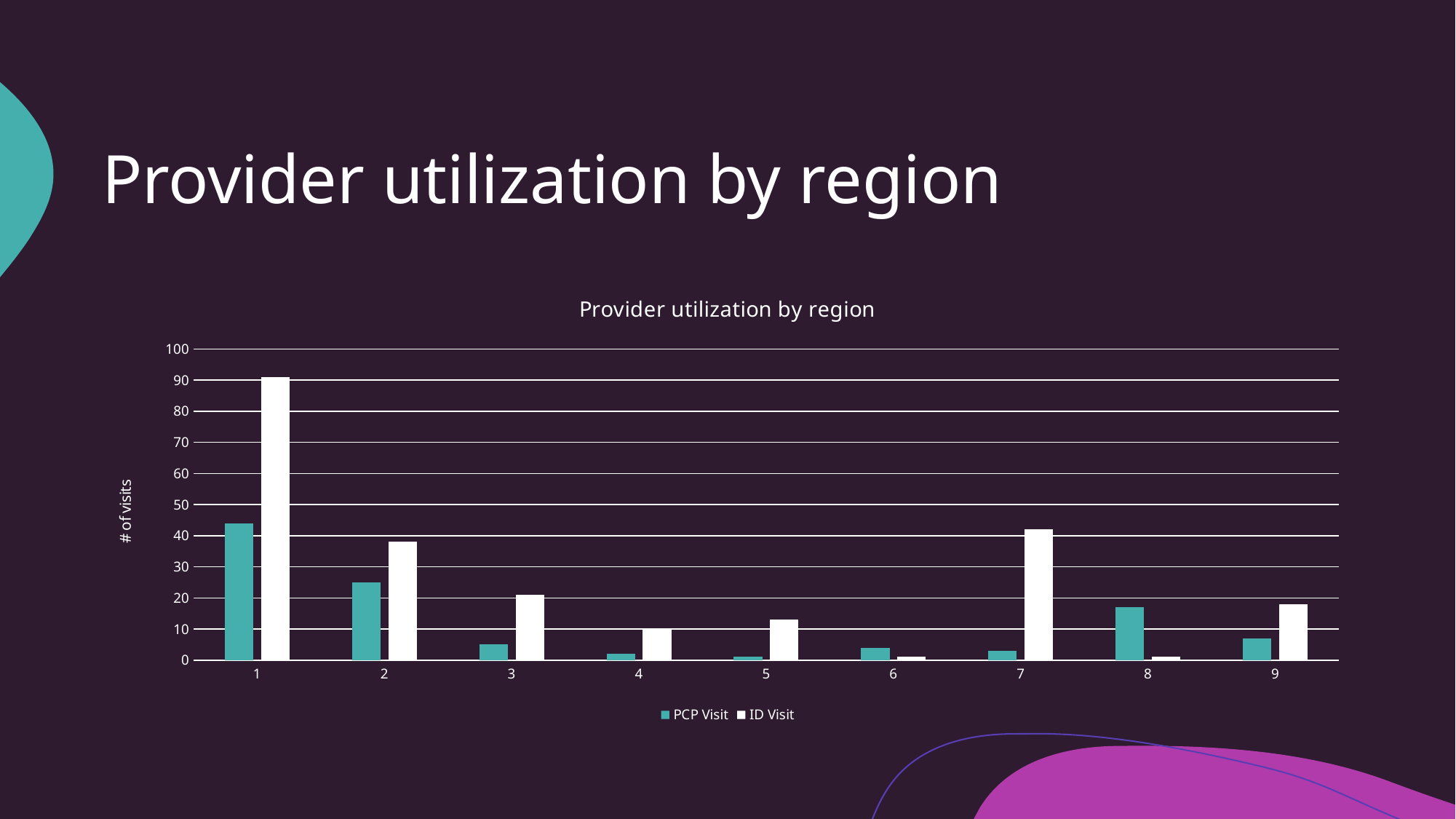
Is the ID Visit value for region 1 greater or less than 80? greater What is the title of the vertical axis? # of visits How many series does the legend list? 2 Is the ID Visit value for region 7 greater or less than 30? greater Is the PCP Visit value for region 2 greater or less than 30? less What kind of chart is shown on the slide? bar chart For region 6, which is larger: PCP Visit or ID Visit? PCP Visit How many regions are shown on the x axis? 9 Which region has the highest PCP Visit value? 1 Which region has the highest ID Visit value? 1 For region 9, which is larger: PCP Visit or ID Visit? ID Visit